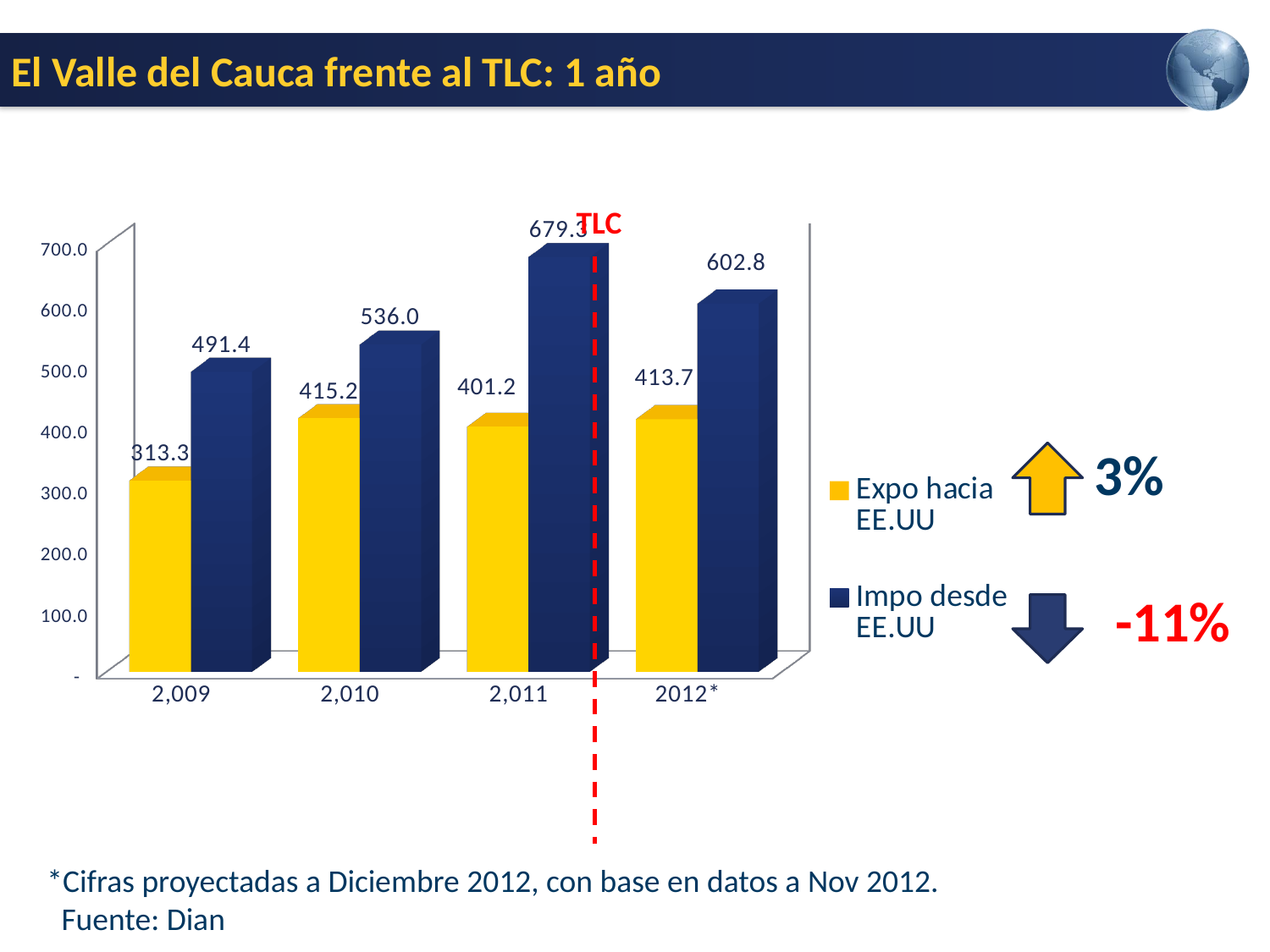
What is the value of Expo hacia EE.UU for 2012*? 413.7 What is the value of Impo desde EE.UU for 2,010? 536.0 What is the value of Impo desde EE.UU for 2012*? 602.8 In which year is Impo desde EE.UU highest? 2,011 What type of chart is shown on the slide? bar chart How many years are shown on the x axis? 4 In which year is Expo hacia EE.UU lowest? 2,009 What is the value of Expo hacia EE.UU for 2,009? 313.3 Is the value for Impo desde EE.UU in 2,011 greater or less than 600.0? greater Which is larger in 2,010: Expo hacia EE.UU or Impo desde EE.UU? Impo desde EE.UU What is the difference between Impo desde EE.UU and Expo hacia EE.UU in 2,009? 178.1 How many series does the legend list? 2